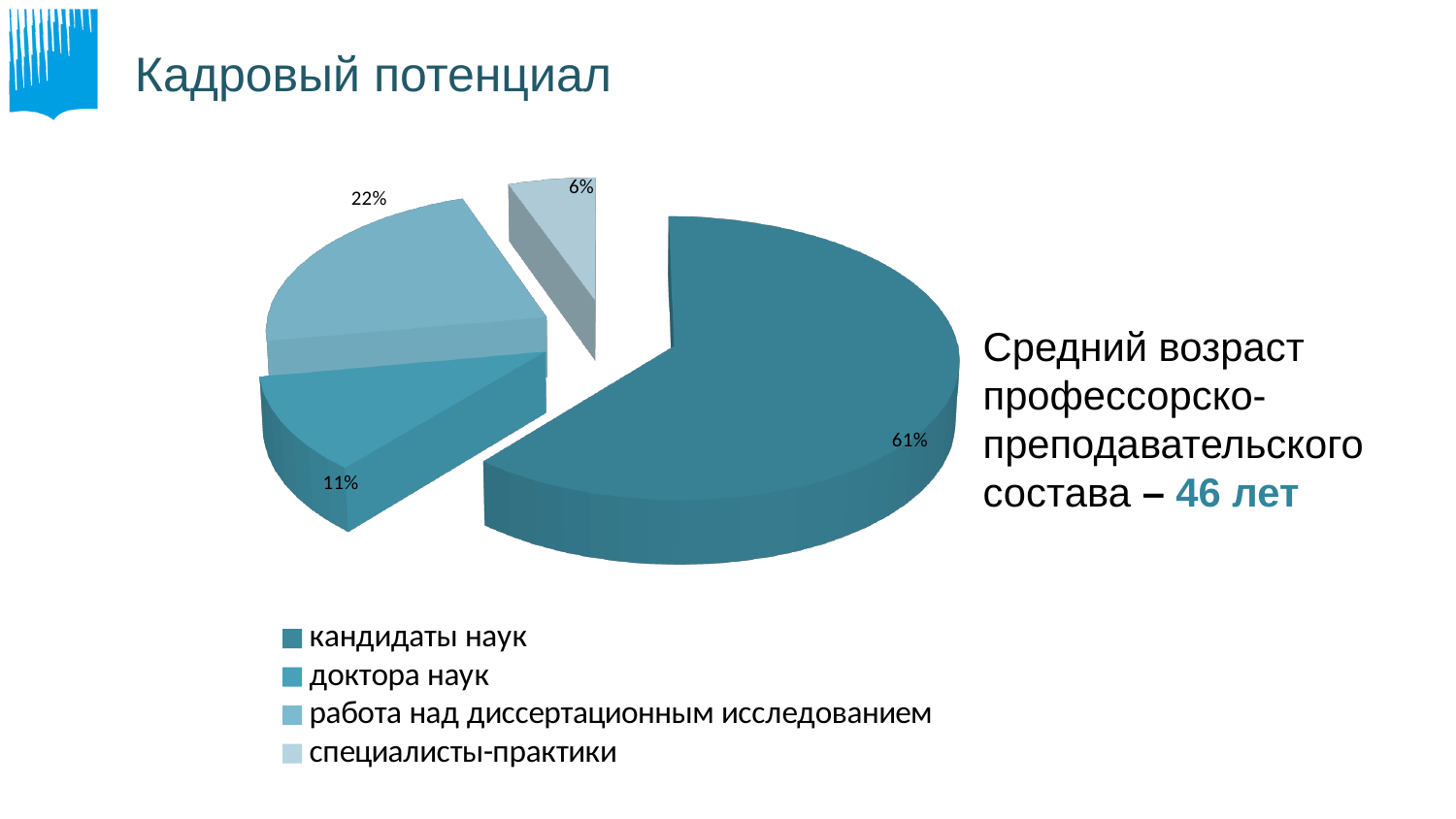
How many entries does the legend list? 4 What kind of chart is shown on the slide? pie chart Which category has the smallest slice of the pie? специалисты-практики What share of the pie is labelled for работа над диссертационным исследованием? 22% What is the difference in percentage points between the кандидаты наук slice and the работа над диссертационным исследованием slice? 39 Which category has the largest slice of the pie? кандидаты наук Which slice is larger: доктора наук or специалисты-практики? доктора наук What share of the pie is labelled for специалисты-практики? 6% What share of the pie is labelled for кандидаты наук? 61% How many slices does the pie chart have? 4 What share of the pie is labelled for доктора наук? 11% What is the title of the slide containing the pie chart? Кадровый потенциал